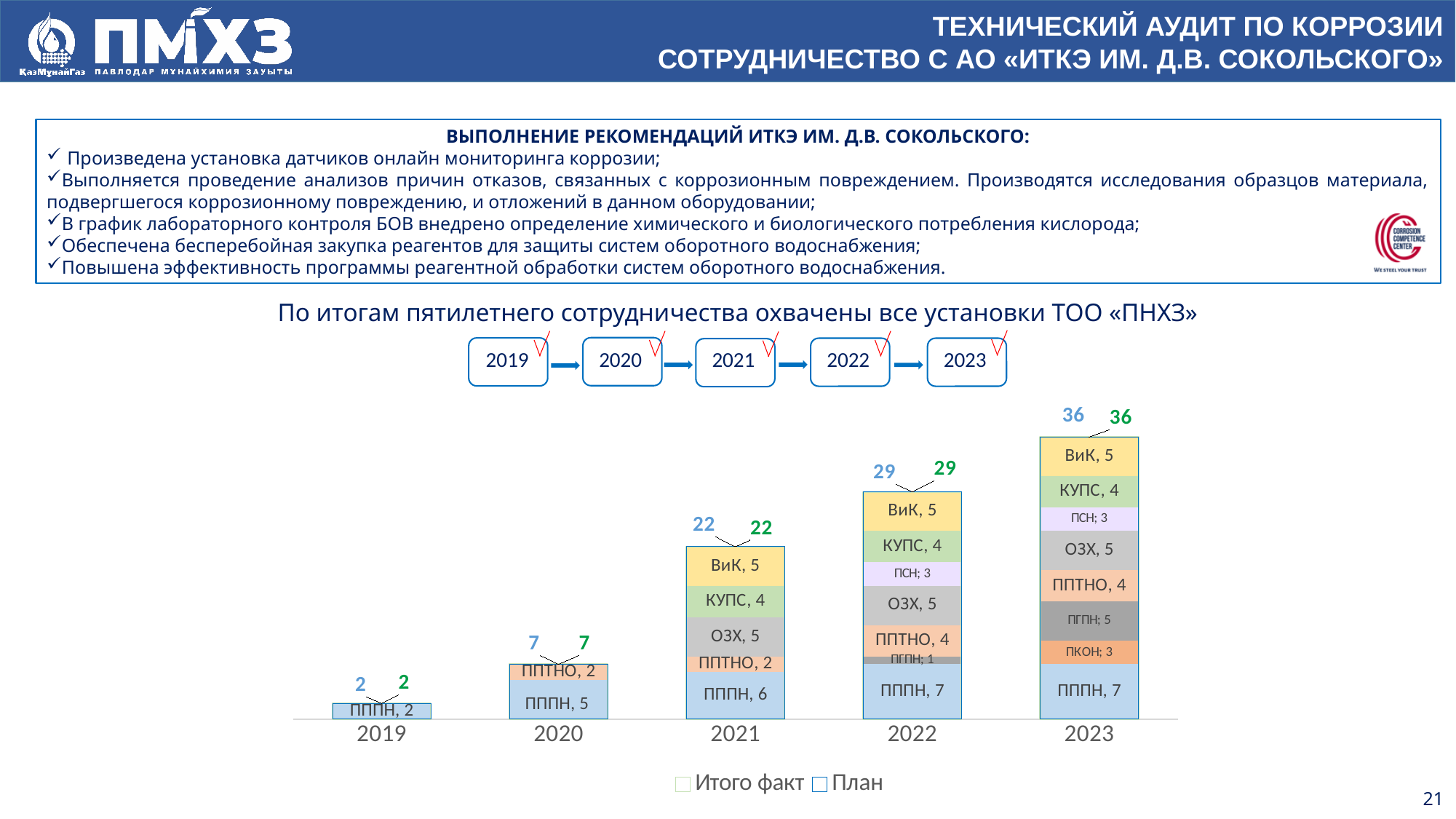
What kind of chart is shown? stacked bar chart What is the total shown above the stacked bar for 2020? 7 What is the difference between the totals for 2023 and 2021? 14 How many years are shown on the x axis? 5 Which year has the highest total? 2023 What is the value of the ПППН segment for 2021? 6 Which year has the lowest total? 2019 What is the value of the ВиК segment for 2023? 5 Do the totals rise or fall from 2019 to 2023? rise What is the value of the ППТНО segment for 2022? 4 What is the total shown above the stacked bar for 2022? 29 Which is larger, the ПППН segment in 2020 or the ПППН segment in 2022? 2022